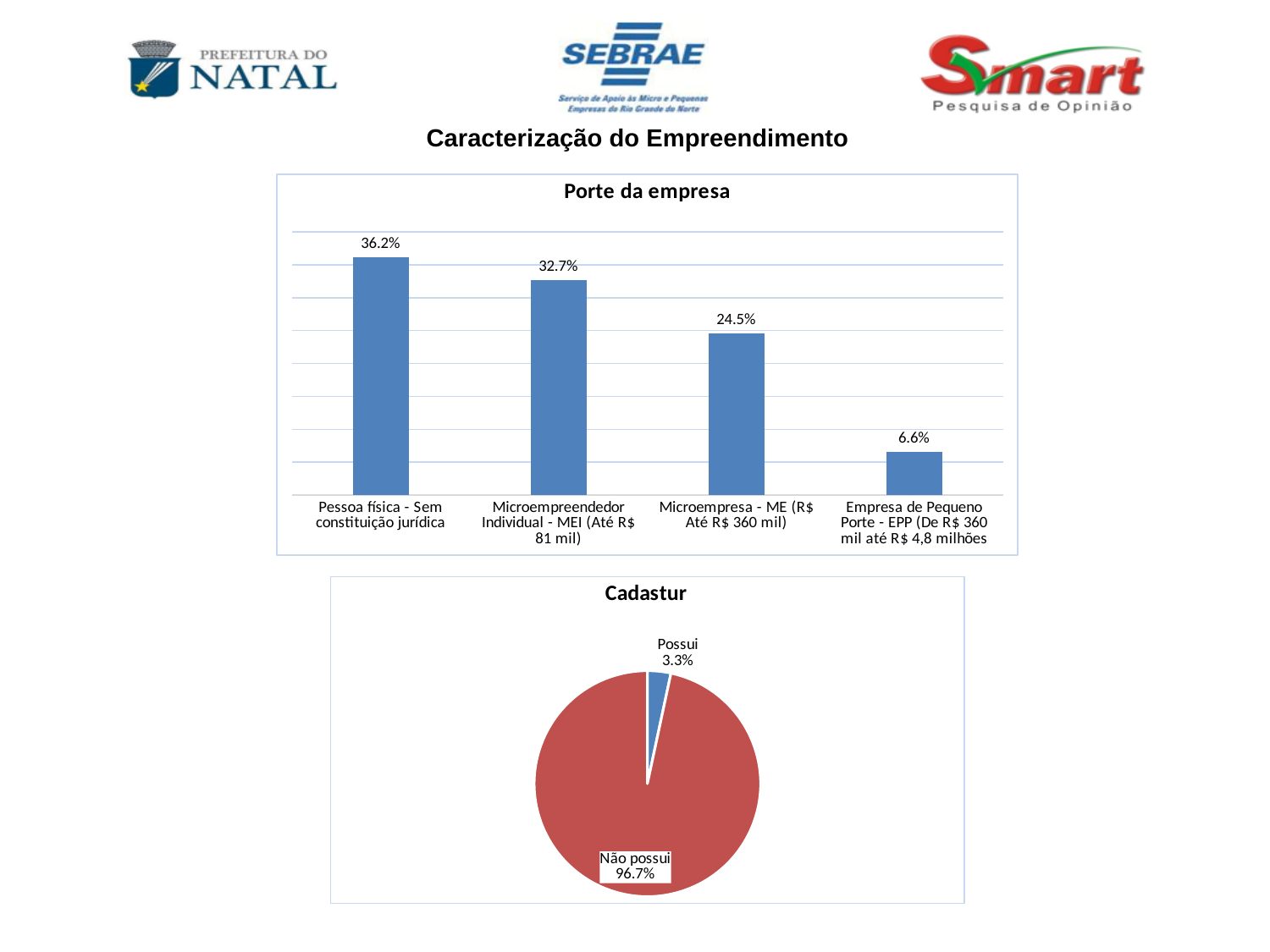
In the 'Porte da empresa' chart, which category has the lowest value? Empresa de Pequeno Porte - EPP (De R$ 360 mil até R$ 4,8 milhões What kind of chart is 'Porte da empresa'? Bar chart In the 'Porte da empresa' chart, which is larger: 'Microempresa - ME (R$ Até R$ 360 mil)' or 'Empresa de Pequeno Porte - EPP'? Microempresa - ME (R$ Até R$ 360 mil) In the 'Porte da empresa' chart, what is the difference between the values for 'Pessoa física - Sem constituição jurídica' and 'Microempreendedor Individual - MEI (Até R$ 81 mil)'? 3.5% In the 'Cadastur' chart, what is the value for 'Possui'? 3.3% In the 'Porte da empresa' chart, what is the value for 'Microempresa - ME (R$ Até R$ 360 mil)'? 24.5% How many categories are shown in the 'Porte da empresa' chart? 4 What kind of chart is 'Cadastur'? Pie chart In the 'Porte da empresa' chart, what is the value for 'Pessoa física - Sem constituição jurídica'? 36.2% In the 'Porte da empresa' chart, which category has the highest value? Pessoa física - Sem constituição jurídica In the 'Porte da empresa' chart, do the values rise or fall from left to right? Fall In the 'Cadastur' chart, what share of the pie is 'Não possui'? 96.7%